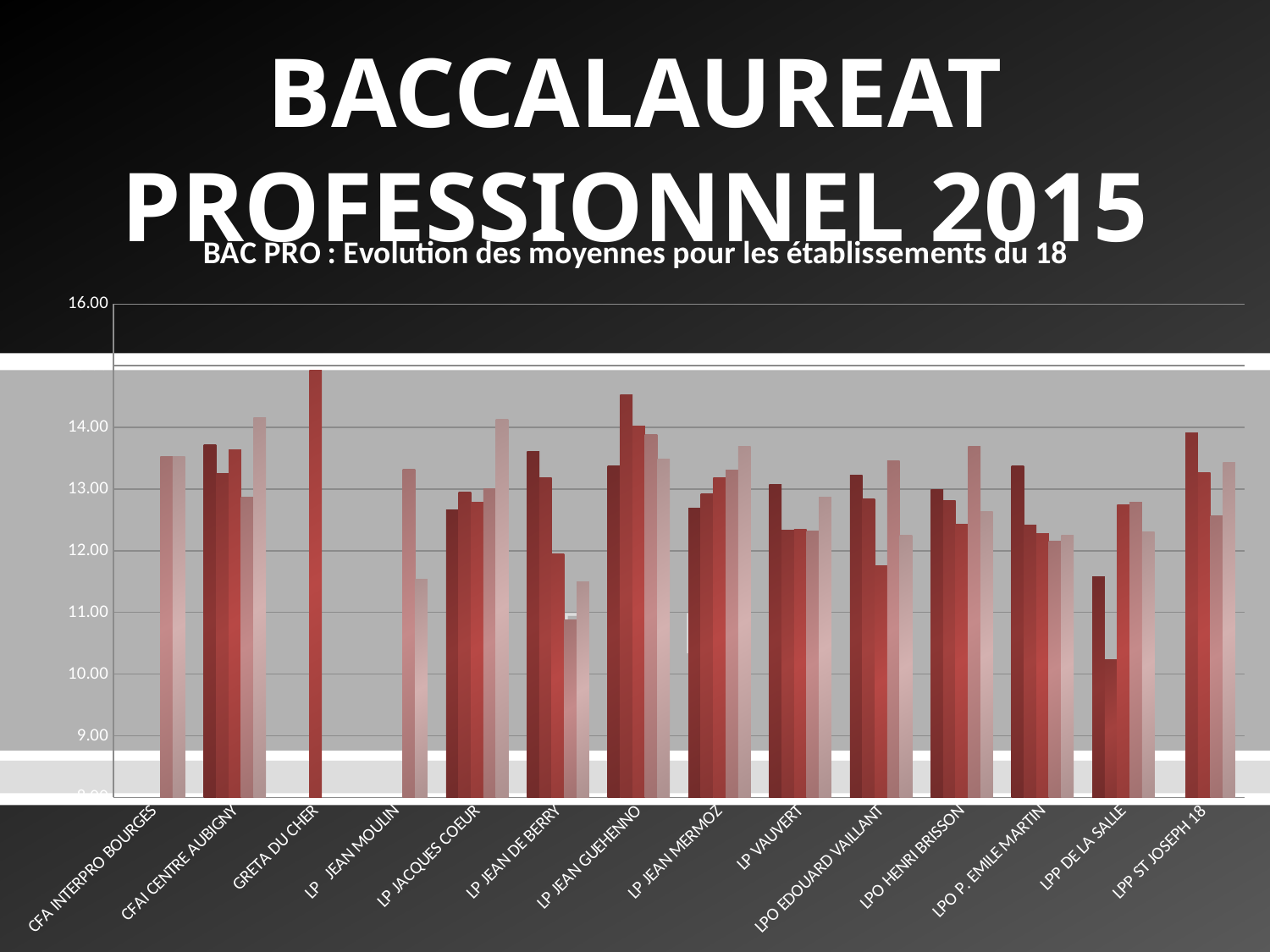
Is the value of the shortest bar for LP JEAN MOULIN greater or less than 12.00? less Is the value of the tallest bar for LP VAUVERT greater or less than 14.00? less Is the value of the shortest bar for LPP DE LA SALLE greater or less than 11.00? less Which establishment has the tallest bar in the chart? GRETA DU CHER Which establishment has the shortest bar in the chart? LPP DE LA SALLE How many establishments (categories) are shown on the x axis of the chart? 14 What is the highest value shown on the vertical axis of the chart? 16.00 What is the title of the chart? BAC PRO : Evolution des moyennes pour les établissements du 18 What kind of chart is shown on the slide? bar chart Which is taller: the tallest bar for CFA INTERPRO BOURGES or the tallest bar for LPP DE LA SALLE? CFA INTERPRO BOURGES